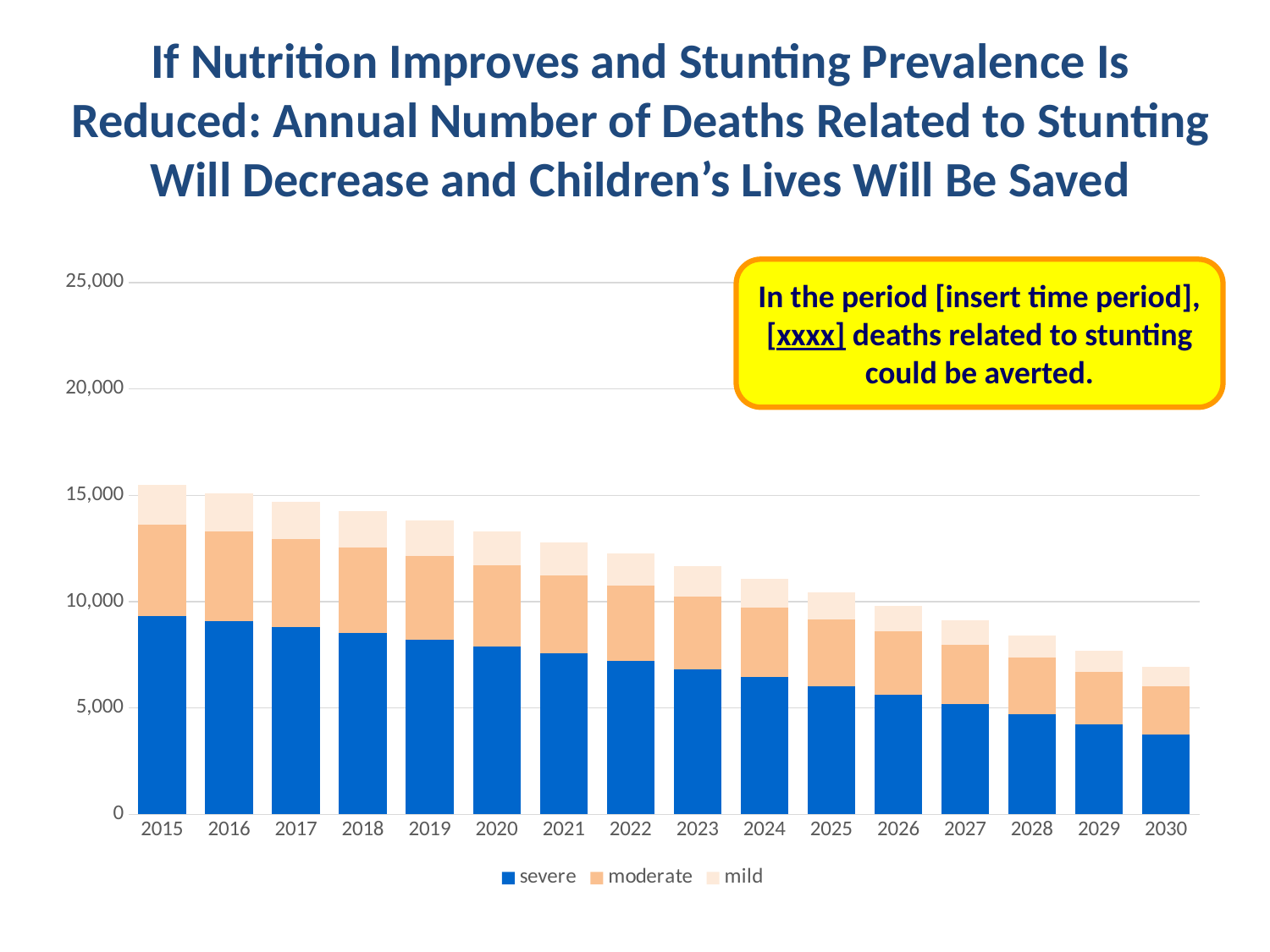
Which year has the shortest stacked bar? 2030 Which year has the tallest stacked bar? 2015 Is the total stacked value for 2030 greater or less than 10,000? less Is the severe value for 2030 greater or less than 5,000? less How many years are shown on the x axis? 16 What kind of chart is shown on the slide? Stacked bar chart Is the total stacked value for 2020 greater or less than 10,000? greater What are the three series listed in the legend? severe, moderate, mild How many series does the legend list? 3 Do the total annual deaths rise or fall from 2015 to 2030? Fall Which is larger, the severe value for 2015 or the severe value for 2030? 2015